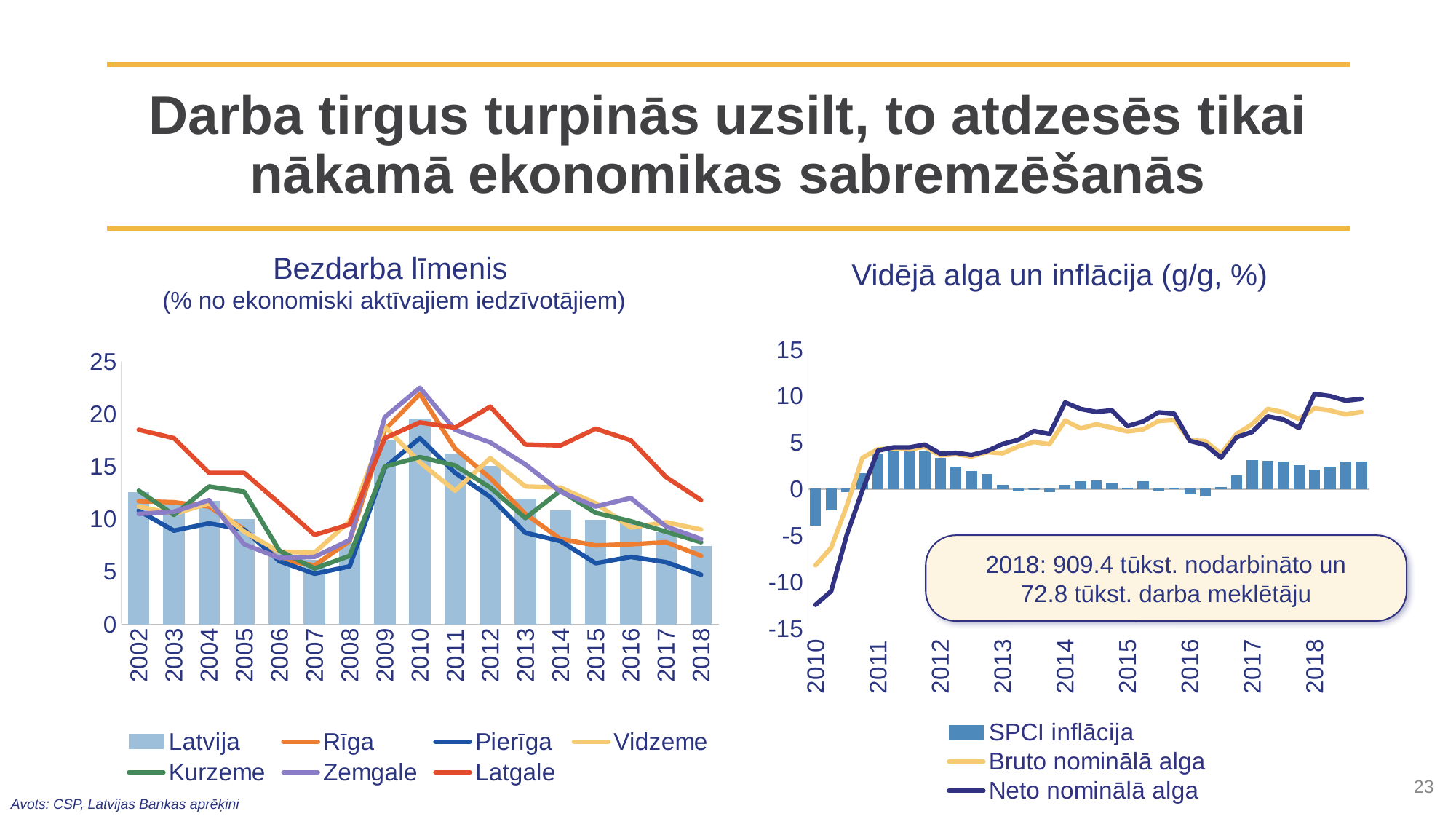
In the left chart 'Bezdarba līmenis', which is larger in 2018: Latgale or Pierīga? Latgale What kind of chart is the left chart, 'Bezdarba līmenis'? A combined bar and line chart How many years are shown on the x axis of the left chart 'Bezdarba līmenis'? 17 In the left chart 'Bezdarba līmenis', do the Latvija bars rise or fall from 2010 to 2018? fall In the left chart 'Bezdarba līmenis', is the Latvija value for 2018 greater or less than 10? less How many series does the legend of the left chart 'Bezdarba līmenis' list? 7 In the left chart 'Bezdarba līmenis', is the Latvija value for 2010 greater or less than 15? greater In the left chart 'Bezdarba līmenis', in which year is the Latvija bar highest? 2010 In the left chart 'Bezdarba līmenis', which region has the highest value in 2002? Latgale In the left chart 'Bezdarba līmenis', in which year is the Latvija bar lowest? 2007 In the right chart 'Vidējā alga un inflācija', is the SPCI inflācija value at the start of 2010 greater or less than 0? less How many series does the legend of the right chart 'Vidējā alga un inflācija' list? 3